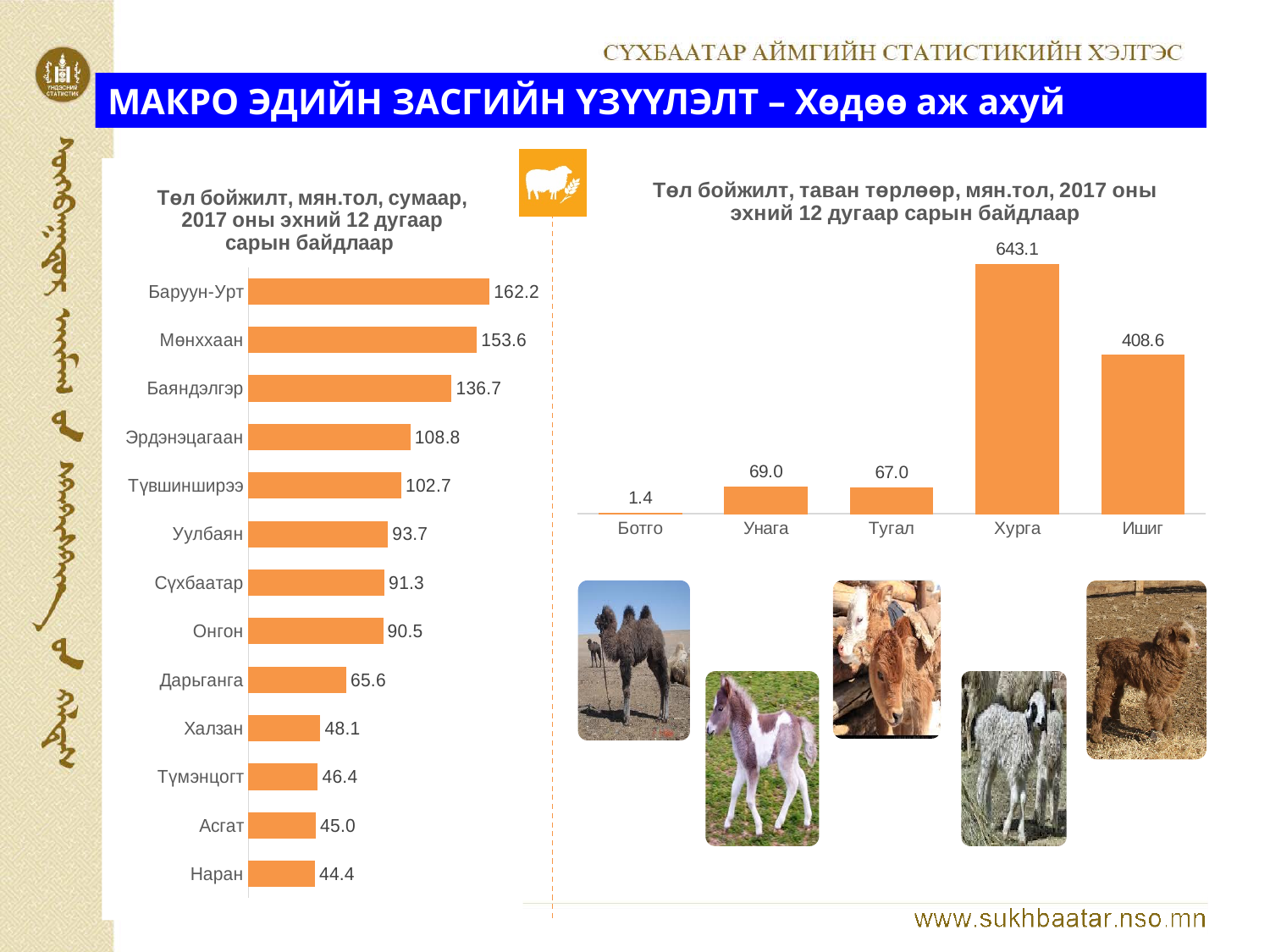
In the left chart (Төл бойжилт, мян.тол, сумаар), how many sums are listed? 13 In the left chart (Төл бойжилт, мян.тол, сумаар), what is the difference between Мөнххаан and Баяндэлгэр? 16.9 In the right chart (Төл бойжилт, таван төрлөөр), which category has the lowest value? Ботго In the right chart (Төл бойжилт, таван төрлөөр), what is the difference between Хурга and Ишиг? 234.5 In the right chart (Төл бойжилт, таван төрлөөр), how many categories are shown? 5 What type of chart is the right chart (Төл бойжилт, таван төрлөөр)? Bar chart In the right chart (Төл бойжилт, таван төрлөөр), what is the value for Ишиг? 408.6 In the left chart (Төл бойжилт, мян.тол, сумаар), which is larger, Уулбаян or Онгон? Уулбаян In the left chart (Төл бойжилт, мян.тол, сумаар), what is the value for Баруун-Урт? 162.2 In the left chart (Төл бойжилт, мян.тол, сумаар), which sum has the lowest value? Наран In the left chart (Төл бойжилт, мян.тол, сумаар), what is the value for Дарьганга? 65.6 In the right chart (Төл бойжилт, таван төрлөөр), which category has the highest value? Хурга